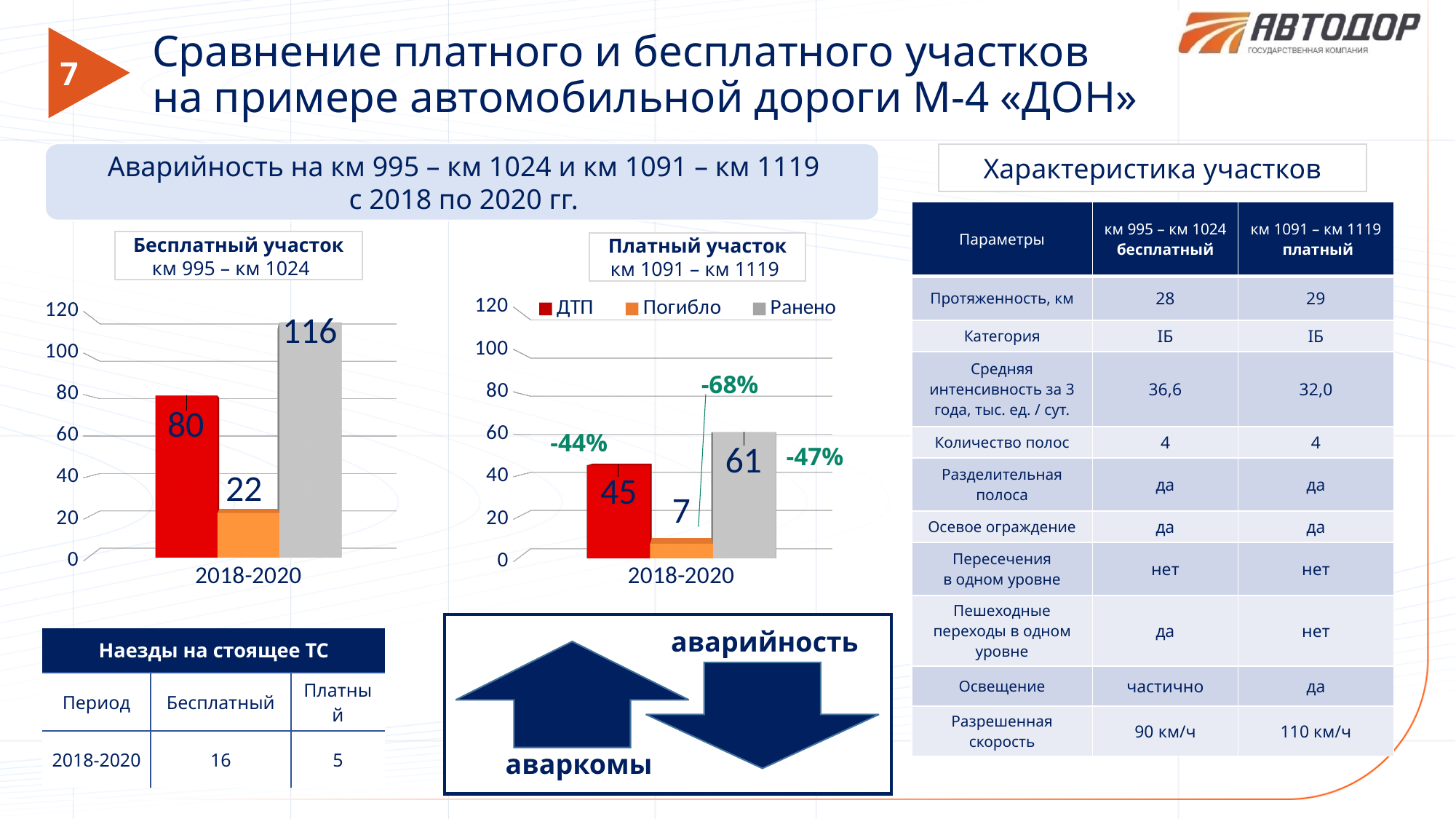
Which is larger: the Погибло value in the free section chart or the Погибло value in the toll section chart? Free section (22) In the chart for the toll section (Платный участок км 1091 – км 1119), which series has the lowest value? Погибло In the chart for the toll section (Платный участок км 1091 – км 1119), what is the value for Погибло? 7 In the chart for the free section (Бесплатный участок км 995 – км 1024), what is the value for Ранено? 116 What percentage change is shown next to the Ранено bar in the toll section chart? -47% In the chart for the free section (Бесплатный участок км 995 – км 1024), what is the value for ДТП? 80 How many series does the legend list for the bar charts? 3 What type of chart is used for the free section (Бесплатный участок км 995 – км 1024)? Bar chart In the chart for the toll section (Платный участок км 1091 – км 1119), what is the value for Ранено? 61 In the chart for the free section (Бесплатный участок км 995 – км 1024), which series has the highest value? Ранено What is the difference between the ДТП value in the free section chart and the ДТП value in the toll section chart? 35 In the chart for the toll section (Платный участок км 1091 – км 1119), is the value for ДТП greater or less than 40? greater